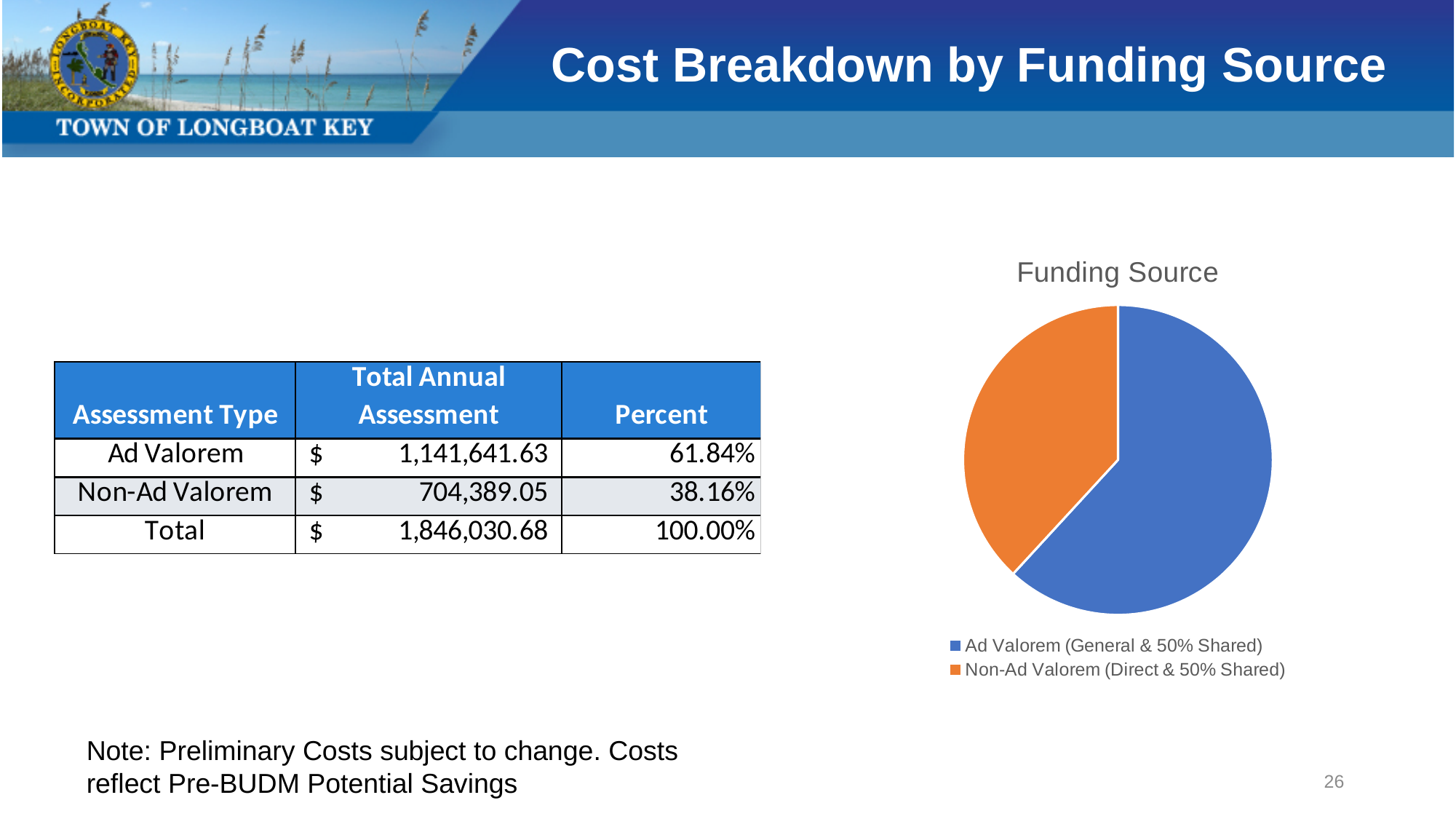
What share of the "Funding Source" pie does Ad Valorem represent, according to the table on the slide? 61.84% How many slices does the "Funding Source" pie chart have? 2 Is the Ad Valorem slice of the "Funding Source" pie chart greater or less than half of the pie? greater Which slice of the "Funding Source" pie chart is the smallest? Non-Ad Valorem (Direct & 50% Shared) What is the title of the pie chart on the slide? Funding Source What colour is the Non-Ad Valorem (Direct & 50% Shared) slice in the "Funding Source" pie chart? orange How many entries does the legend of the "Funding Source" chart list? 2 What kind of chart is the "Funding Source" chart? pie chart What share of the "Funding Source" pie does Non-Ad Valorem represent, according to the table on the slide? 38.16% In the "Funding Source" pie chart, which is larger: the Ad Valorem slice or the Non-Ad Valorem slice? Ad Valorem Which slice of the "Funding Source" pie chart is the largest? Ad Valorem (General & 50% Shared)